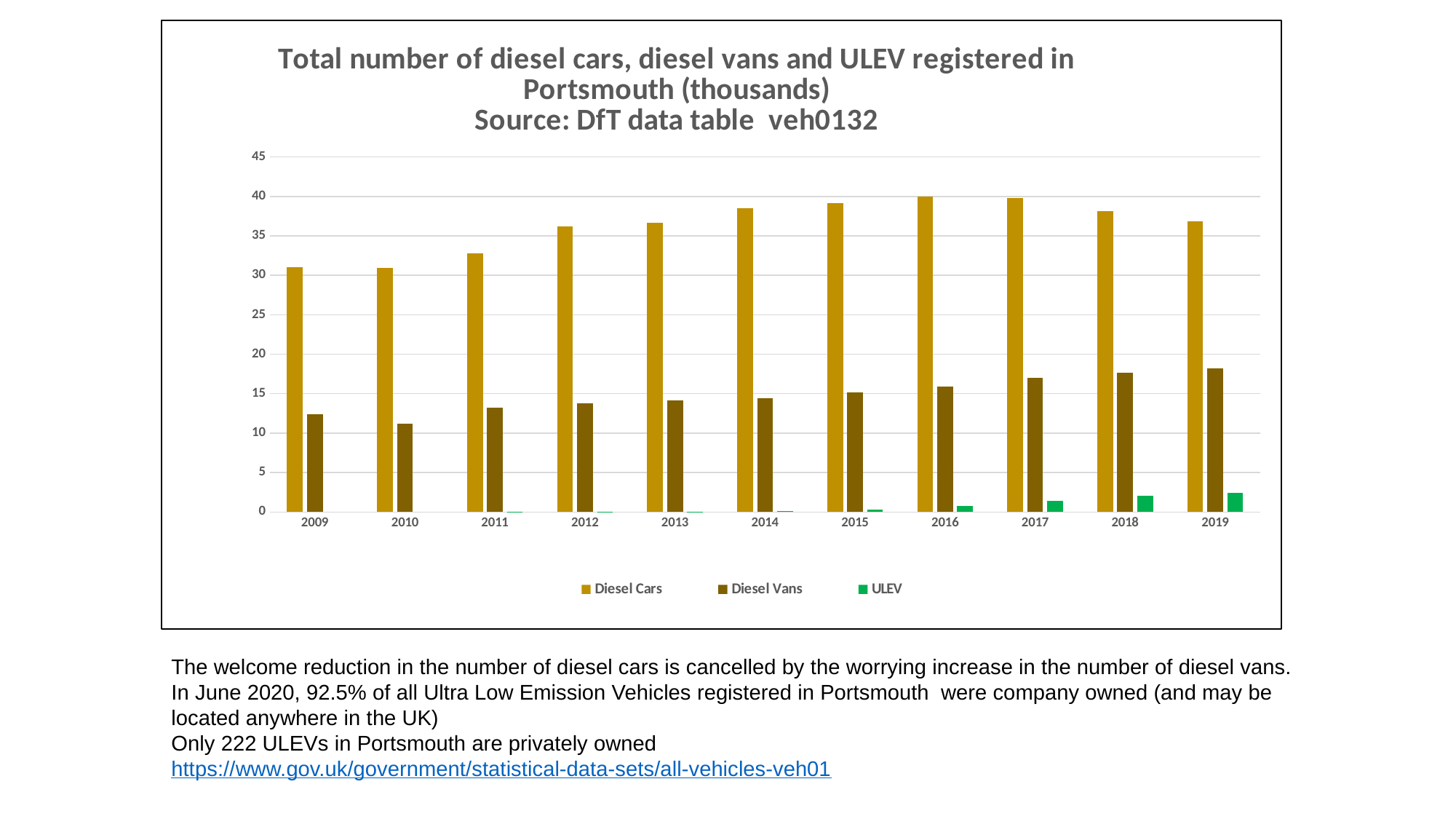
How many years are shown on the x axis? 11 How many series does the legend list? 3 Which is larger in 2019, Diesel Cars or Diesel Vans? Diesel Cars Do the Diesel Vans values rise or fall from 2010 to 2019? rise Is the value for Diesel Cars in 2016 greater or less than 35? greater Is the value for ULEV in 2019 greater or less than 5? less Which year has the highest value for Diesel Vans? 2019 Which year has the lowest value for Diesel Vans? 2010 What kind of chart is shown on the slide? bar chart Is the value for Diesel Vans in 2019 greater or less than 20? less Which year has the highest value for ULEV? 2019 Which series is shown in green in the legend? ULEV